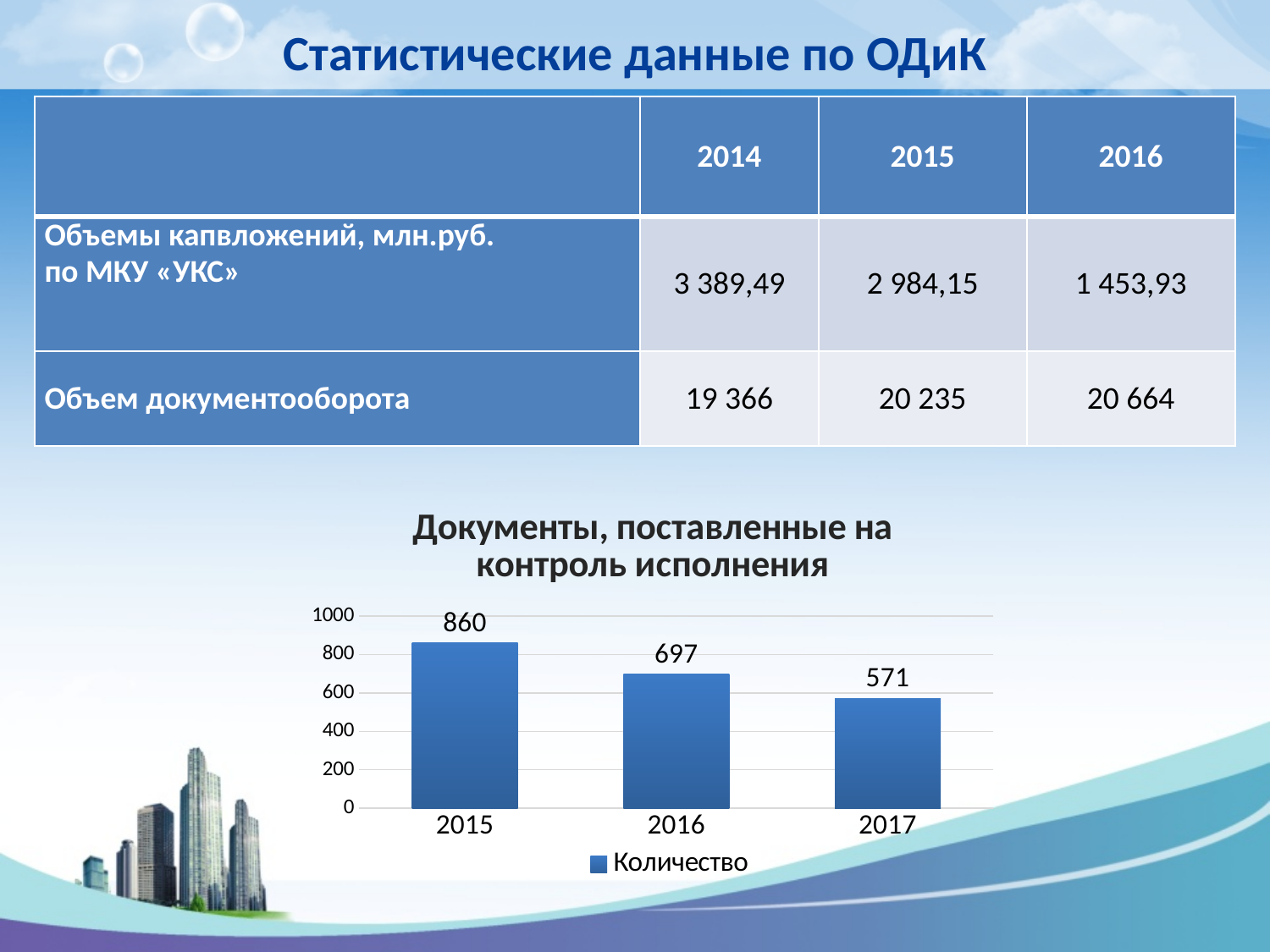
Which is larger, the value for 2016 or the value for 2017? 2016 What is the difference between the values for 2015 and 2016? 163 What is the difference between the values for 2015 and 2017? 289 What is the value for 2017 in the chart? 571 Do the values rise or fall from 2015 to 2017? fall Which year has the lowest value in the chart? 2017 What is the value for 2016 in the chart? 697 Which year has the highest value in the chart? 2015 Is the value for 2017 greater or less than 600? less What kind of chart is shown on the slide? bar chart What is the value for 2015 in the chart? 860 How many years are shown in the chart? 3